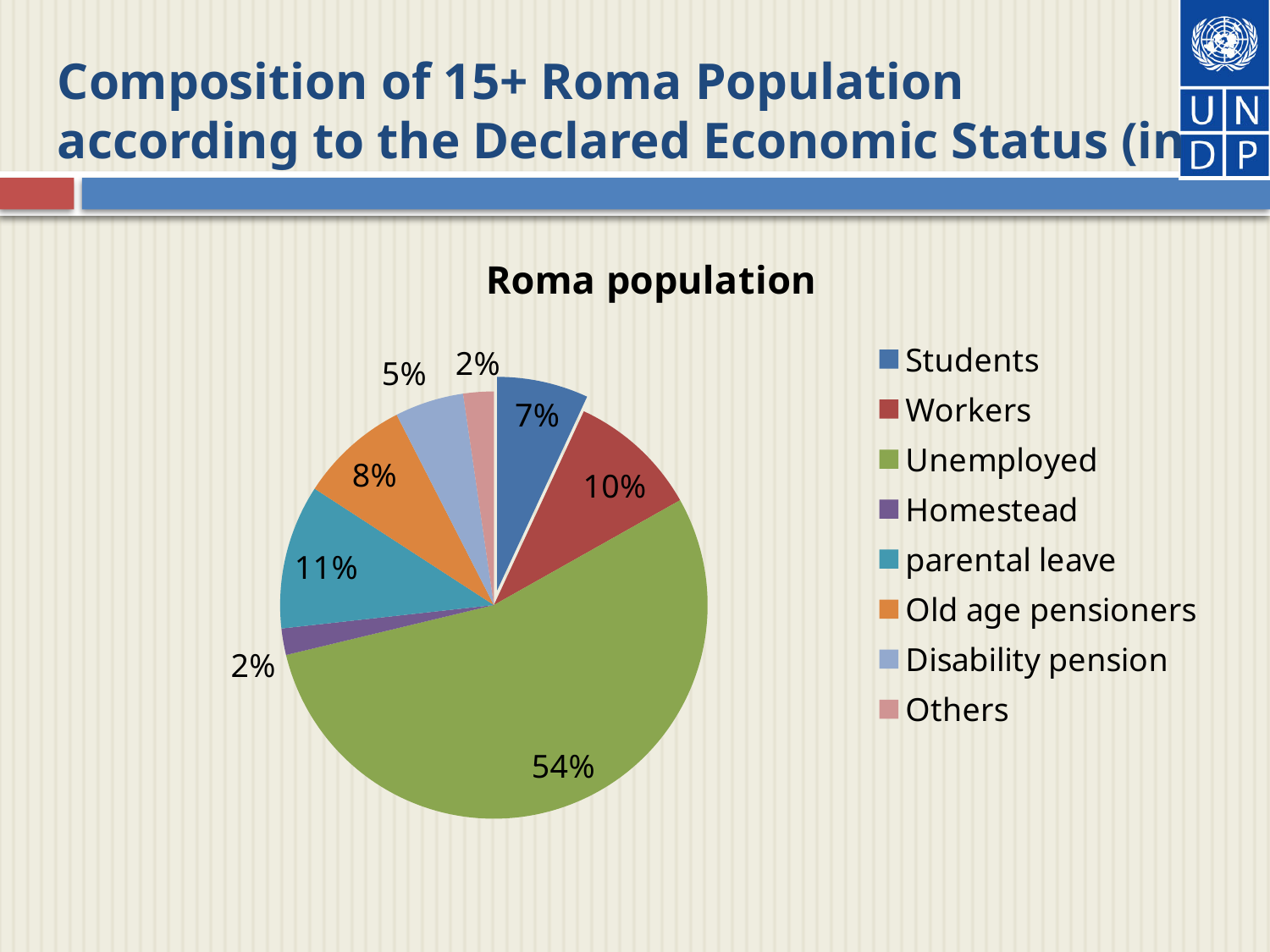
What share of the Roma population is Workers? 10% What is the difference between the Unemployed share and the parental leave share? 43% How many categories does the legend list? 8 Which category has the largest share of the pie? Unemployed What share of the Roma population is Students? 7% What colour is the Unemployed slice? green What type of chart is shown on the slide? pie chart What share of the Roma population is Unemployed? 54% Which is larger, the share for Workers or the share for Old age pensioners? Workers What share of the Roma population is Old age pensioners? 8% What is the chart's title? Roma population What share of the Roma population is on parental leave? 11%